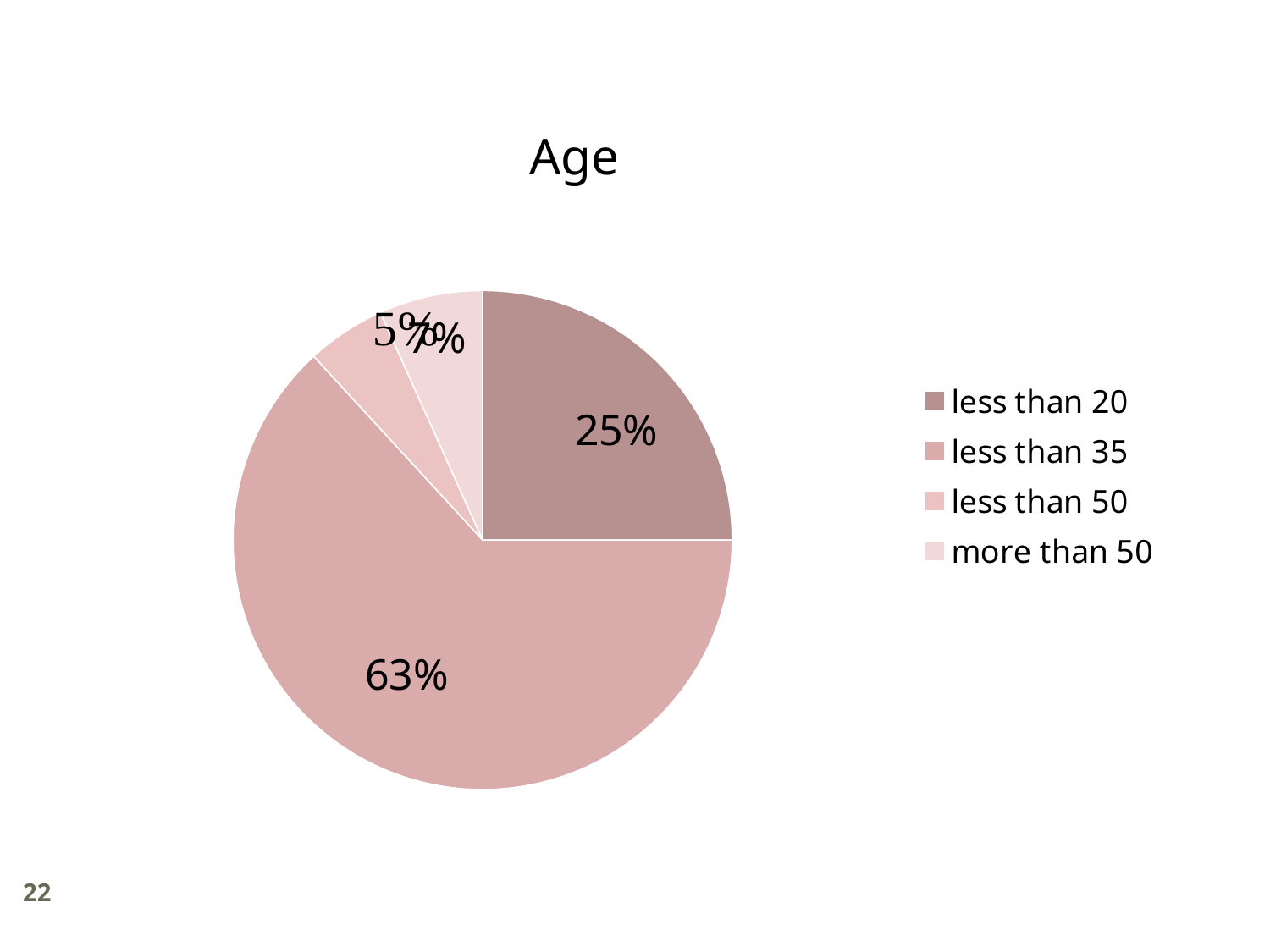
What is the difference in percentage points between the 'less than 35' slice and the 'less than 20' slice? 38 Which age category has the largest slice of the pie? less than 35 Which slice is larger, 'less than 20' or 'less than 35'? less than 35 What share of the pie does the 'less than 35' slice represent? 63% What share of the pie does the 'less than 20' slice represent? 25% Which legend entry is listed first? less than 20 What type of chart is shown on the slide? pie chart How many categories does the legend list? 4 What is the title of the chart? Age Is the share for 'less than 35' greater or less than 50%? greater Which slice is larger, 'less than 20' or 'more than 50'? less than 20